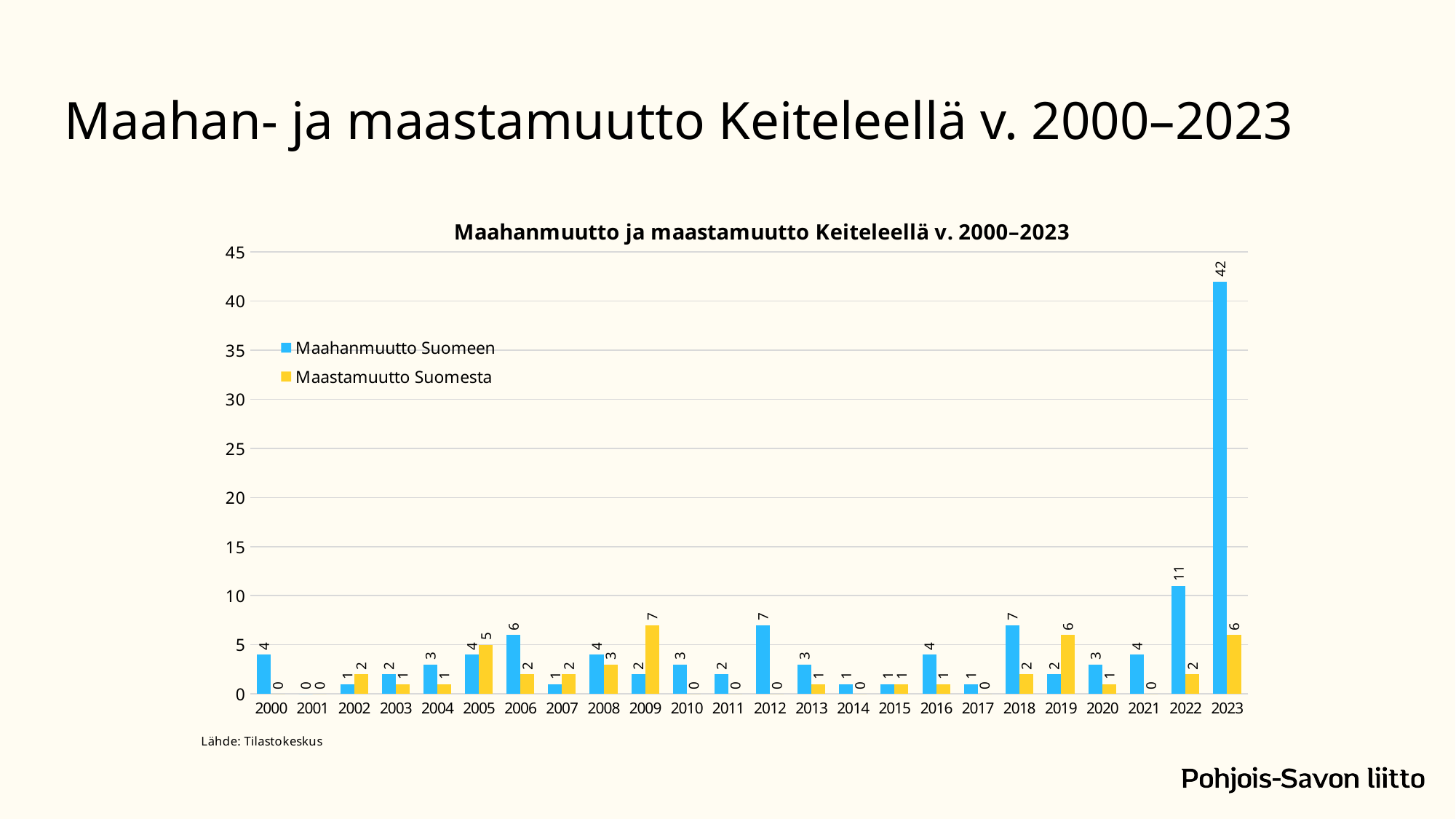
What kind of chart is shown on the slide? Bar chart What is the value of Maastamuutto Suomesta in 2009? 7 How many years are shown on the x axis of the chart? 24 Which year has the highest value for Maastamuutto Suomesta? 2009 What is the value of Maahanmuutto Suomeen in 2022? 11 What is the difference between Maahanmuutto Suomeen and Maastamuutto Suomesta in 2023? 36 Is the value for Maahanmuutto Suomeen in 2023 greater or less than 40? greater How many series does the legend list? 2 What is the value of Maahanmuutto Suomeen in 2023? 42 What is the title of the chart? Maahanmuutto ja maastamuutto Keiteleellä v. 2000–2023 In 2019, which is larger: Maahanmuutto Suomeen or Maastamuutto Suomesta? Maastamuutto Suomesta Which year has the highest value for Maahanmuutto Suomeen? 2023